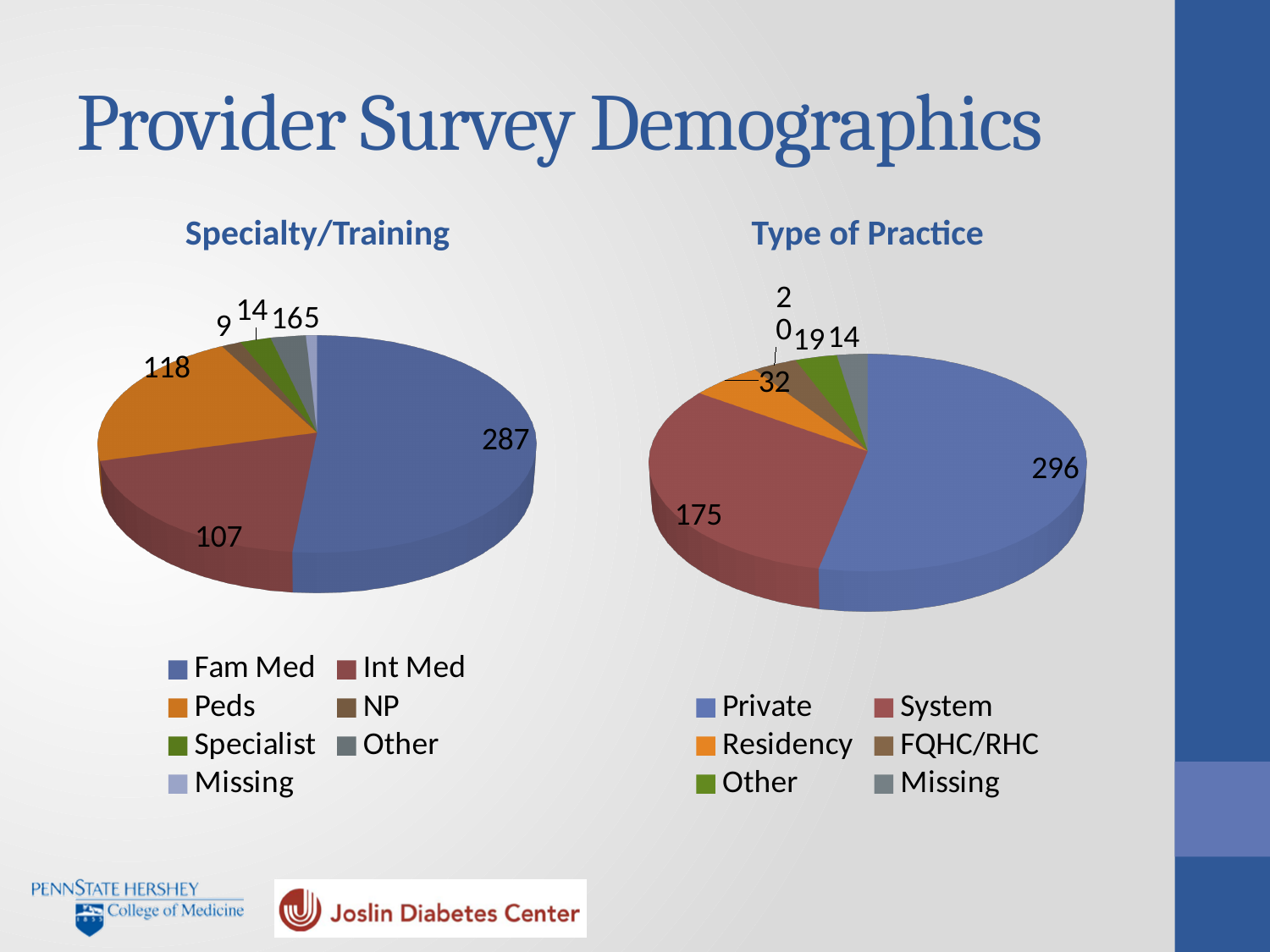
In the Specialty/Training chart, which category has the largest slice? Fam Med In the Specialty/Training chart, what is the value for Peds? 118 In the Type of Practice chart, what is the value for Residency? 32 In the Type of Practice chart, what is the difference between Private and System? 121 In the Specialty/Training chart, what is the value for Int Med? 107 In the Specialty/Training chart, what is the difference between Fam Med and Int Med? 180 What kind of chart is the Type of Practice chart? Pie chart In the Type of Practice chart, what is the value for System? 175 In the Specialty/Training chart, which is larger, Peds or Int Med? Peds In the Type of Practice chart, what is the value for Private? 296 In the Type of Practice chart, which category has the largest slice? Private In the Specialty/Training chart, what is the value for Fam Med? 287